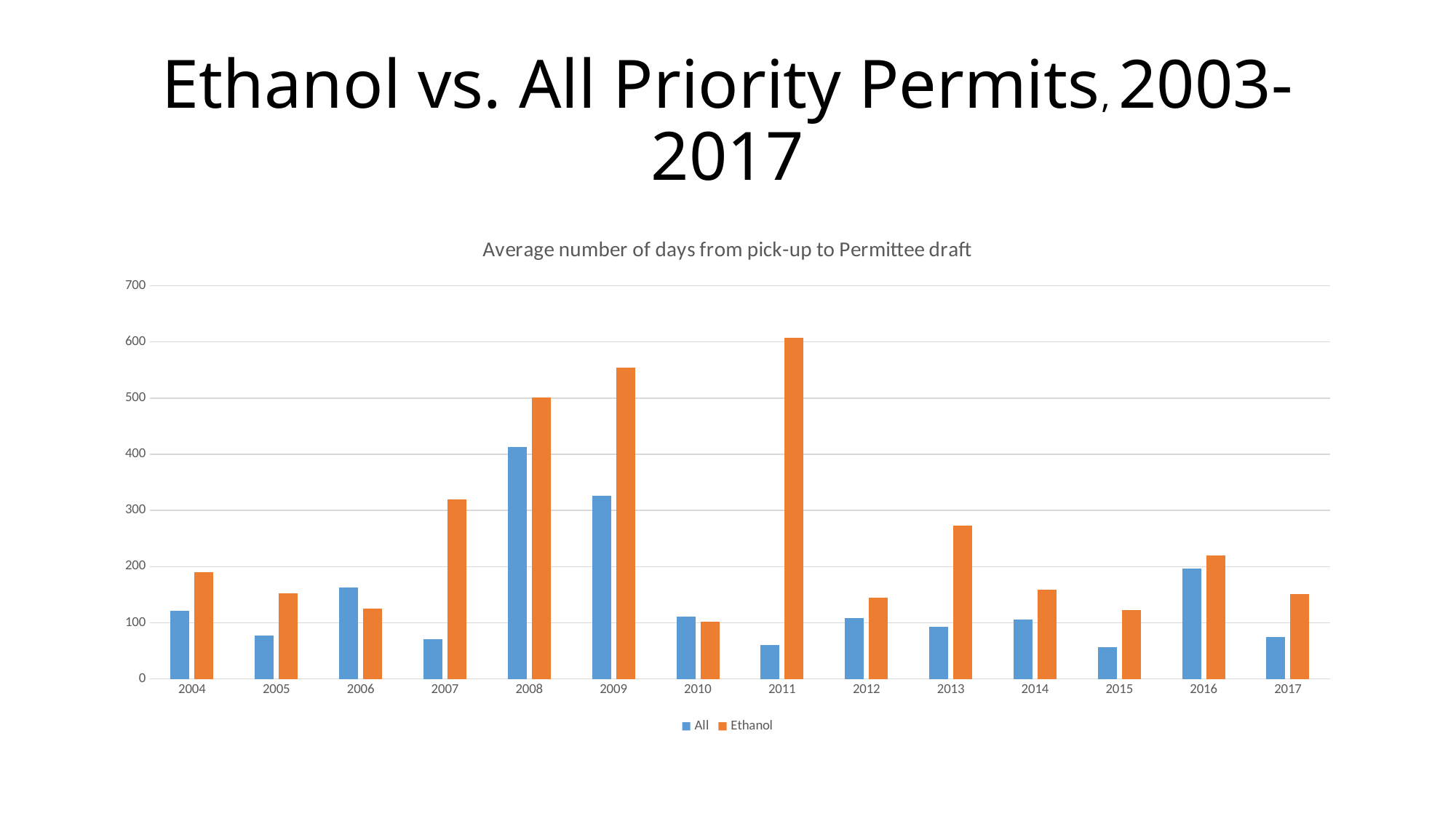
How many years are shown on the x axis? 14 In which year is the Ethanol value lowest? 2010 Is the All value for 2008 greater or less than 300? greater Is the Ethanol value for 2009 greater or less than 500? greater Is the Ethanol value for 2013 greater or less than 300? less How many series does the legend list? 2 In which year is the All value highest? 2008 What is the chart's title? Average number of days from pick-up to Permittee draft In 2006, which series has the larger value, All or Ethanol? All In 2008, which series has the larger value, All or Ethanol? Ethanol What kind of chart is shown on the slide? bar chart In which year is the Ethanol value highest? 2011